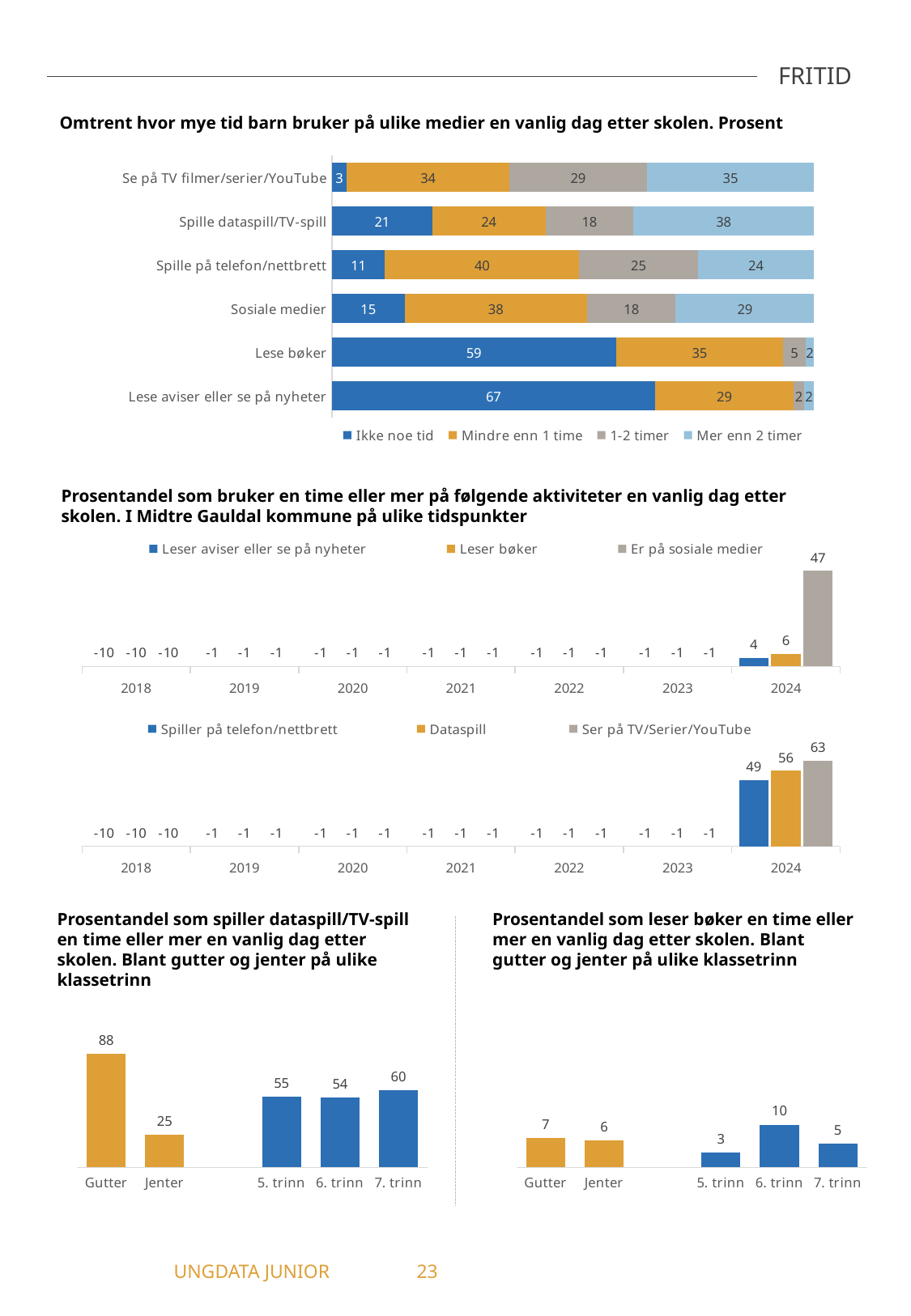
In the chart 'Omtrent hvor mye tid barn bruker på ulike medier en vanlig dag etter skolen. Prosent', which category has the highest value for 'Ikke noe tid'? Lese aviser eller se på nyheter In the chart 'Omtrent hvor mye tid barn bruker på ulike medier en vanlig dag etter skolen. Prosent', how many categories are shown? 6 In the second chart under 'Prosentandel som bruker en time eller mer på følgende aktiviteter', which series has the highest value in 2024? Ser på TV/Serier/YouTube In the chart 'Prosentandel som spiller dataspill/TV-spill en time eller mer en vanlig dag etter skolen', what is the value for 'Gutter'? 88 In the chart 'Omtrent hvor mye tid barn bruker på ulike medier en vanlig dag etter skolen. Prosent', how many series does the legend list? 4 What kind of chart is 'Prosentandel som leser bøker en time eller mer en vanlig dag etter skolen'? Bar chart In the chart 'Omtrent hvor mye tid barn bruker på ulike medier en vanlig dag etter skolen. Prosent', what is the value for 'Mer enn 2 timer' for 'Spille dataspill/TV-spill'? 38 In the second chart under 'Prosentandel som bruker en time eller mer på følgende aktiviteter', what is the difference between 'Dataspill' and 'Spiller på telefon/nettbrett' in 2024? 7 In the chart 'Prosentandel som leser bøker en time eller mer en vanlig dag etter skolen', which category has the lowest value? 5. trinn In the chart 'Omtrent hvor mye tid barn bruker på ulike medier en vanlig dag etter skolen. Prosent', what is the difference between the 'Mindre enn 1 time' values for 'Spille på telefon/nettbrett' and 'Se på TV filmer/serier/YouTube'? 6 In the first chart under 'Prosentandel som bruker en time eller mer på følgende aktiviteter', what is the value for 'Er på sosiale medier' in 2024? 47 In the chart 'Prosentandel som spiller dataspill/TV-spill en time eller mer en vanlig dag etter skolen', which of '5. trinn' and '7. trinn' has the larger value? 7. trinn